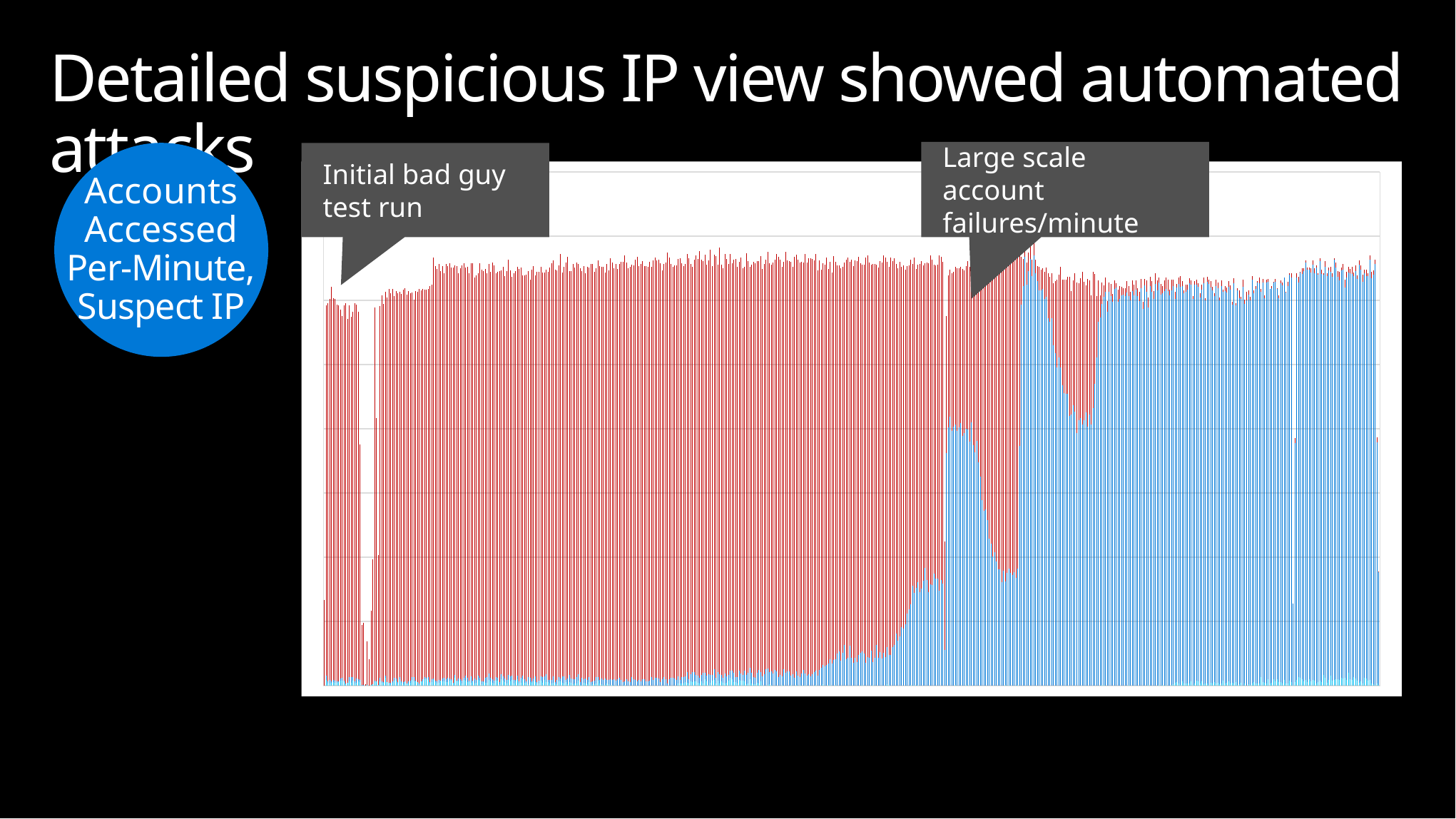
What kind of chart is shown on the slide? bar chart On the left half of the chart, which colour of bars is taller, red or blue? red Do the blue bars rise or fall from left to right along the x axis? rise What does the callout pointing at the left side of the chart say? Initial bad guy test run What two colours are the bars in the chart? red and blue At the far right end of the chart, which colour of bars is taller, red or blue? blue